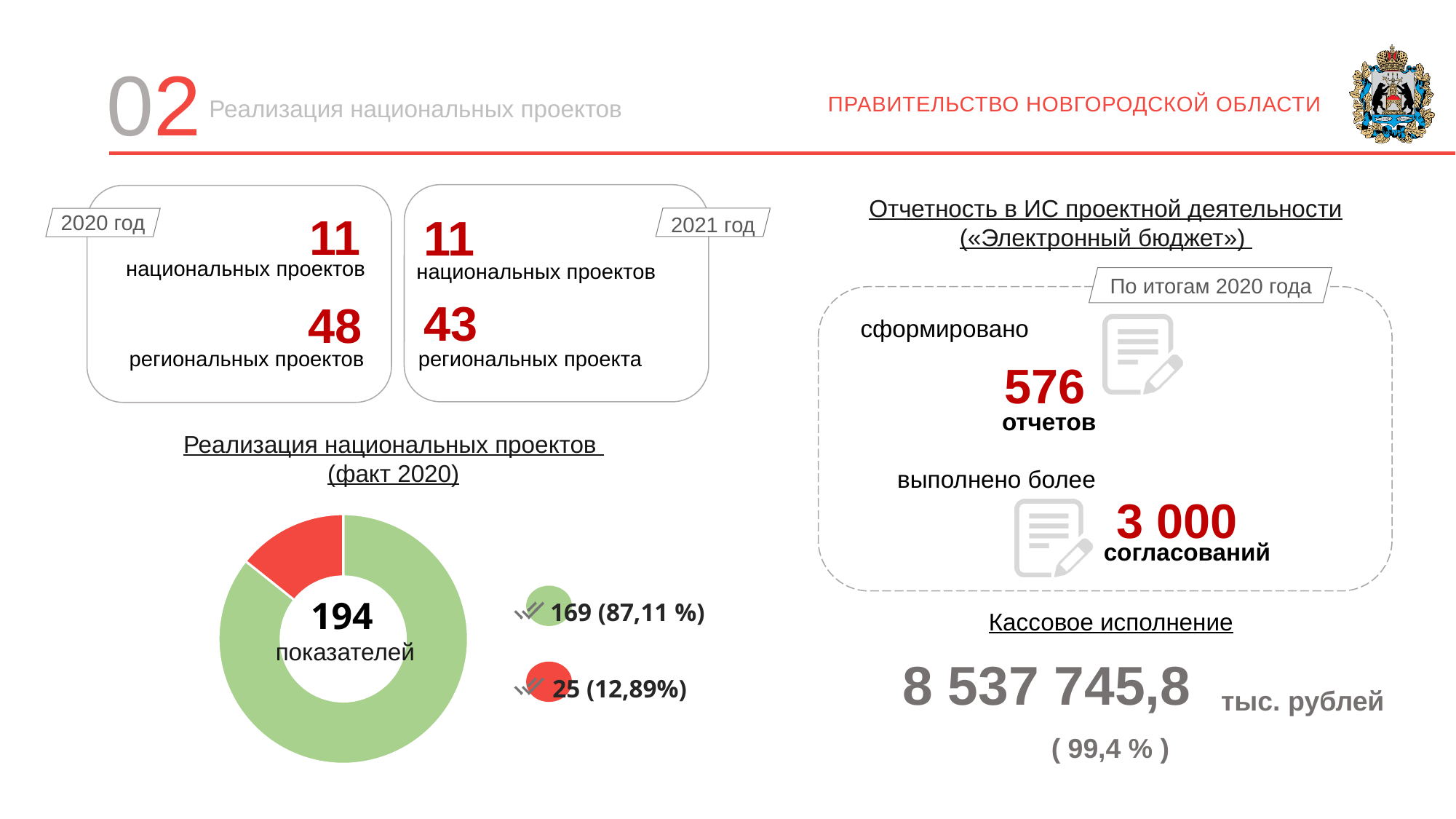
What word is printed under the number 194 in the centre of the donut chart? показателей What share of the donut chart does the red segment represent? 12,89% What kind of chart is shown under the title "Реализация национальных проектов (факт 2020)"? Donut (pie) chart How many segments does the donut chart have? 2 Which segment of the donut chart is the smallest? The red segment (25) What is the difference between the green segment value and the red segment value in the donut chart? 144 How many entries does the legend next to the donut chart list? 2 What total number is printed in the centre of the donut chart? 194 What value is shown for the green segment of the donut chart? 169 (87,11 %) Which segment of the donut chart is larger, the green one or the red one? The green one What value is shown for the red segment of the donut chart? 25 (12,89%) What share of the donut chart does the green segment represent? 87,11 %